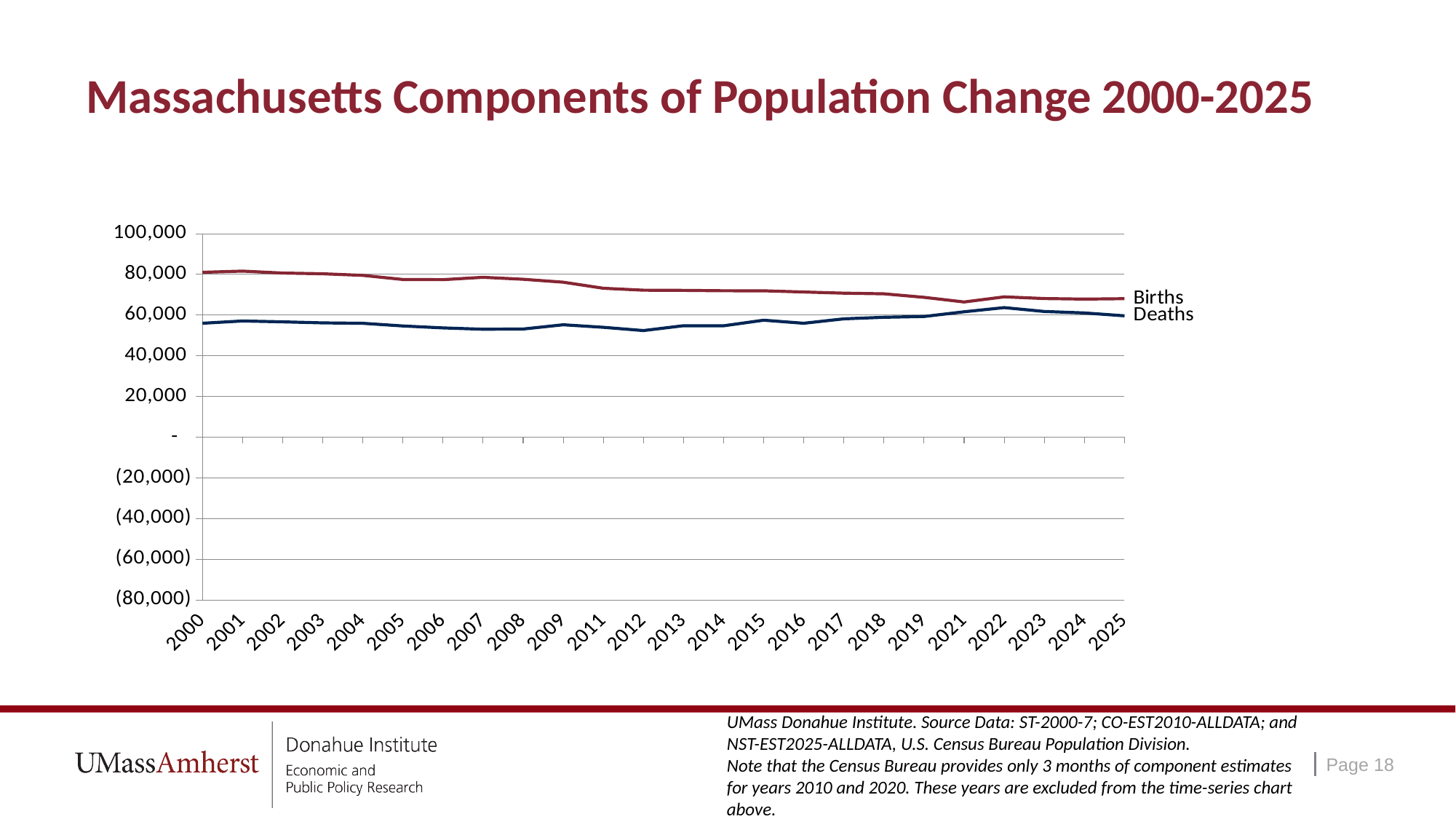
Which series is drawn in dark red? Births Is the value for Births in 2012 greater or less than 60,000? greater What kind of chart is shown on the slide? Line chart Do Deaths rise or fall overall from 2000 to 2025? Rise Is the value for Births in 2025 greater or less than 80,000? less Is the value for Deaths in 2000 greater or less than 60,000? less In 2000, which is larger, Births or Deaths? Births Do Births rise or fall overall from 2000 to 2025? Fall How many series does the chart show? 2 How many years are plotted along the x axis? 24 What are the two series labelled on the chart? Births and Deaths